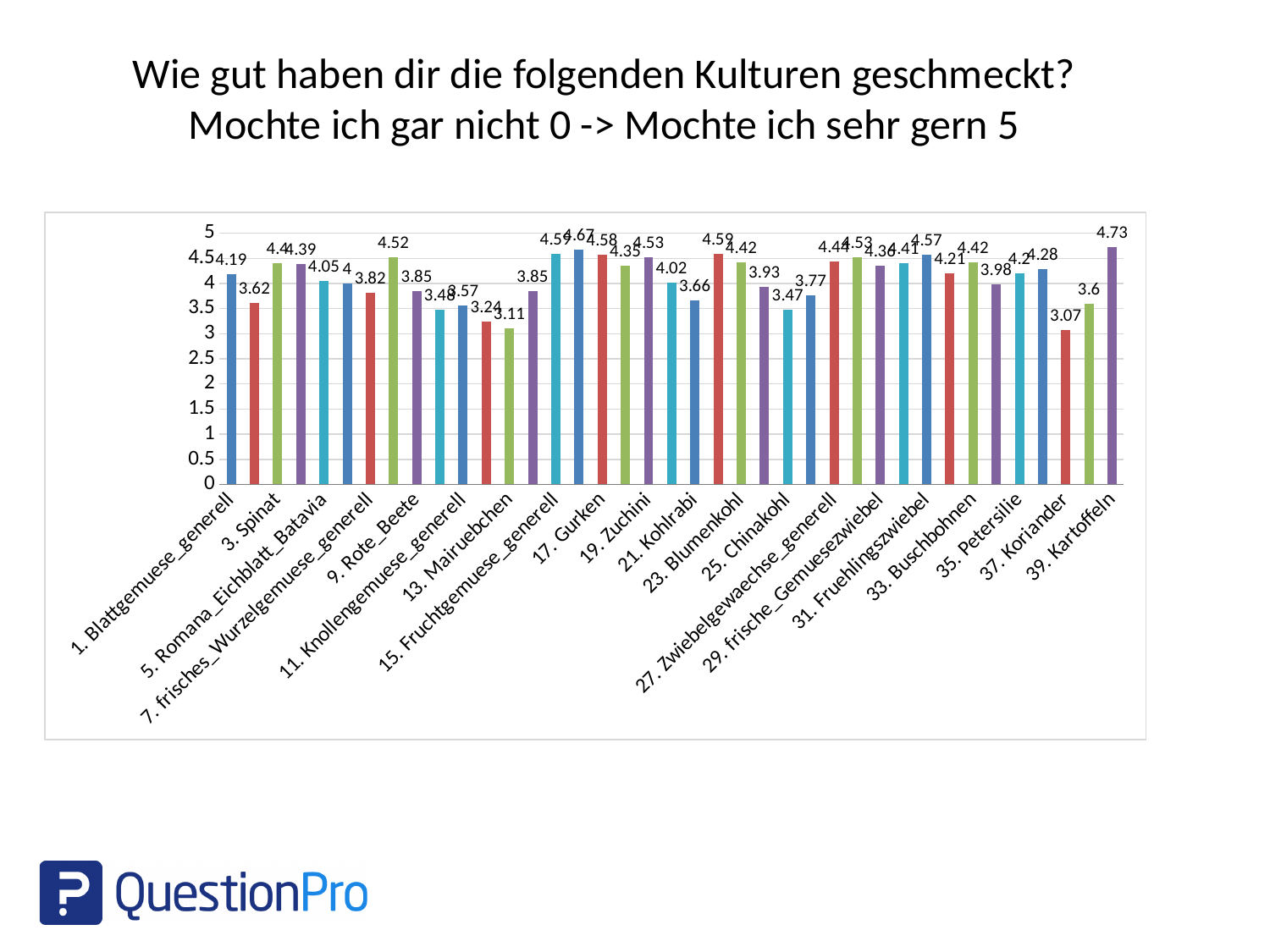
What is the difference between the values for 39. Kartoffeln and 37. Koriander? 1.66 Which has a higher value, 17. Gurken or 21. Kohlrabi? 17. Gurken What is the value for 17. Gurken? 4.58 What is the title of the slide? Wie gut haben dir die folgenden Kulturen geschmeckt? Mochte ich gar nicht 0 -> Mochte ich sehr gern 5 What is the value for 13. Mairuebchen? 3.11 Which labelled category has the lowest value? 37. Koriander What is the value for 37. Koriander? 3.07 What is the value for 3. Spinat? 4.4 What kind of chart is shown on the slide? bar chart Is the value for 25. Chinakohl greater or less than 4? less What is the value for 39. Kartoffeln? 4.73 Which labelled category has the highest value? 39. Kartoffeln